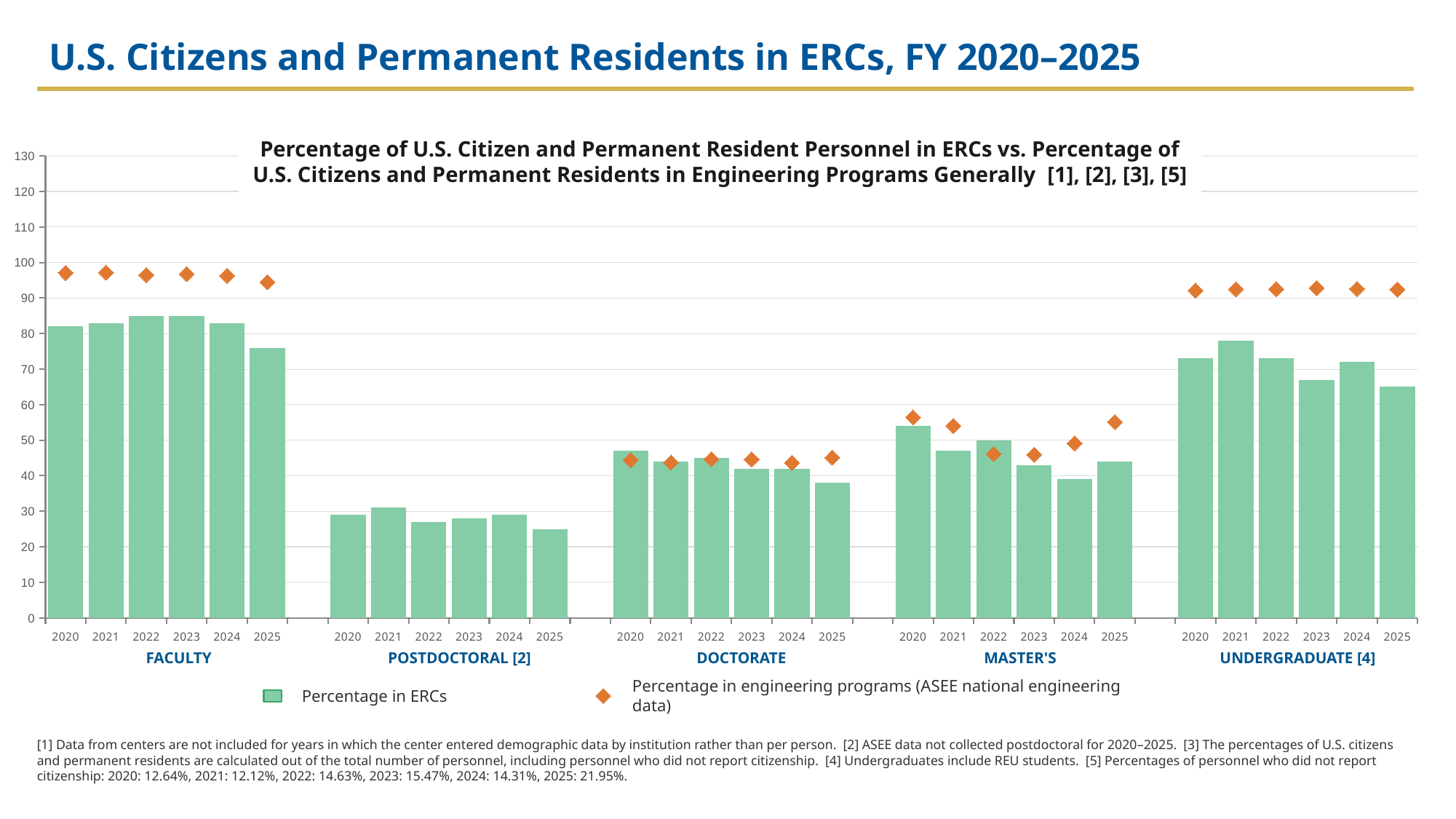
How many series does the legend list? 2 Which is larger: the Percentage in ERCs bar for DOCTORATE in 2020 or for MASTER'S in 2020? MASTER'S in 2020 How many personnel groups (categories) are shown along the x axis? 5 Is the Percentage in ERCs bar for MASTER'S in 2020 greater or less than 50? greater Which year has the lowest Percentage in ERCs bar in the FACULTY group? 2025 Which year has the highest Percentage in ERCs bar in the UNDERGRADUATE [4] group? 2021 Which year has the lowest Percentage in ERCs bar in the DOCTORATE group? 2025 How many years are plotted for each personnel group? 6 Is the Percentage in ERCs bar for FACULTY in 2025 greater or less than 80? less Which year has the highest Percentage in ERCs bar in the MASTER'S group? 2020 What kind of chart is shown on the slide? Bar chart Which personnel group has no Percentage in engineering programs (ASEE) diamond markers plotted? POSTDOCTORAL [2]